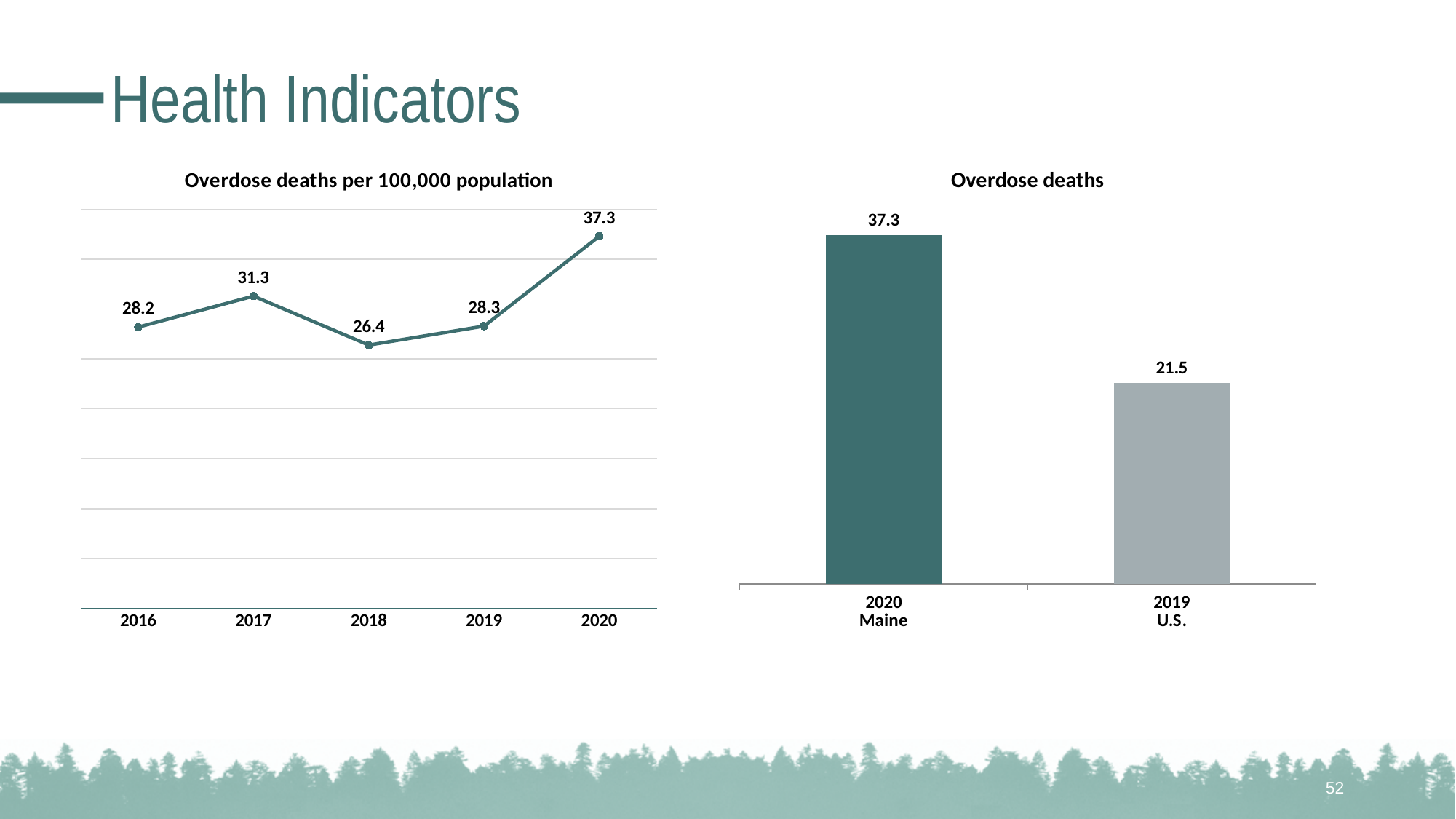
In the 'Overdose deaths per 100,000 population' chart, what is the difference between the 2020 value and the 2019 value? 9.0 In the 'Overdose deaths per 100,000 population' chart, which year has the highest value? 2020 In the 'Overdose deaths' chart, which is larger, 2020 Maine or 2019 U.S.? 2020 Maine In the 'Overdose deaths per 100,000 population' chart, how many years are plotted? 5 What kind of chart is the 'Overdose deaths per 100,000 population' chart? Line chart In the 'Overdose deaths' chart, what is the value for 2019 U.S.? 21.5 In the 'Overdose deaths per 100,000 population' chart, does the value rise or fall from 2019 to 2020? Rise In the 'Overdose deaths' chart, what is the difference between the 2020 Maine value and the 2019 U.S. value? 15.8 In the 'Overdose deaths per 100,000 population' chart, what is the value for 2018? 26.4 In the 'Overdose deaths per 100,000 population' chart, what is the value for 2017? 31.3 What kind of chart is the 'Overdose deaths' chart? Bar chart In the 'Overdose deaths per 100,000 population' chart, which year has the lowest value? 2018